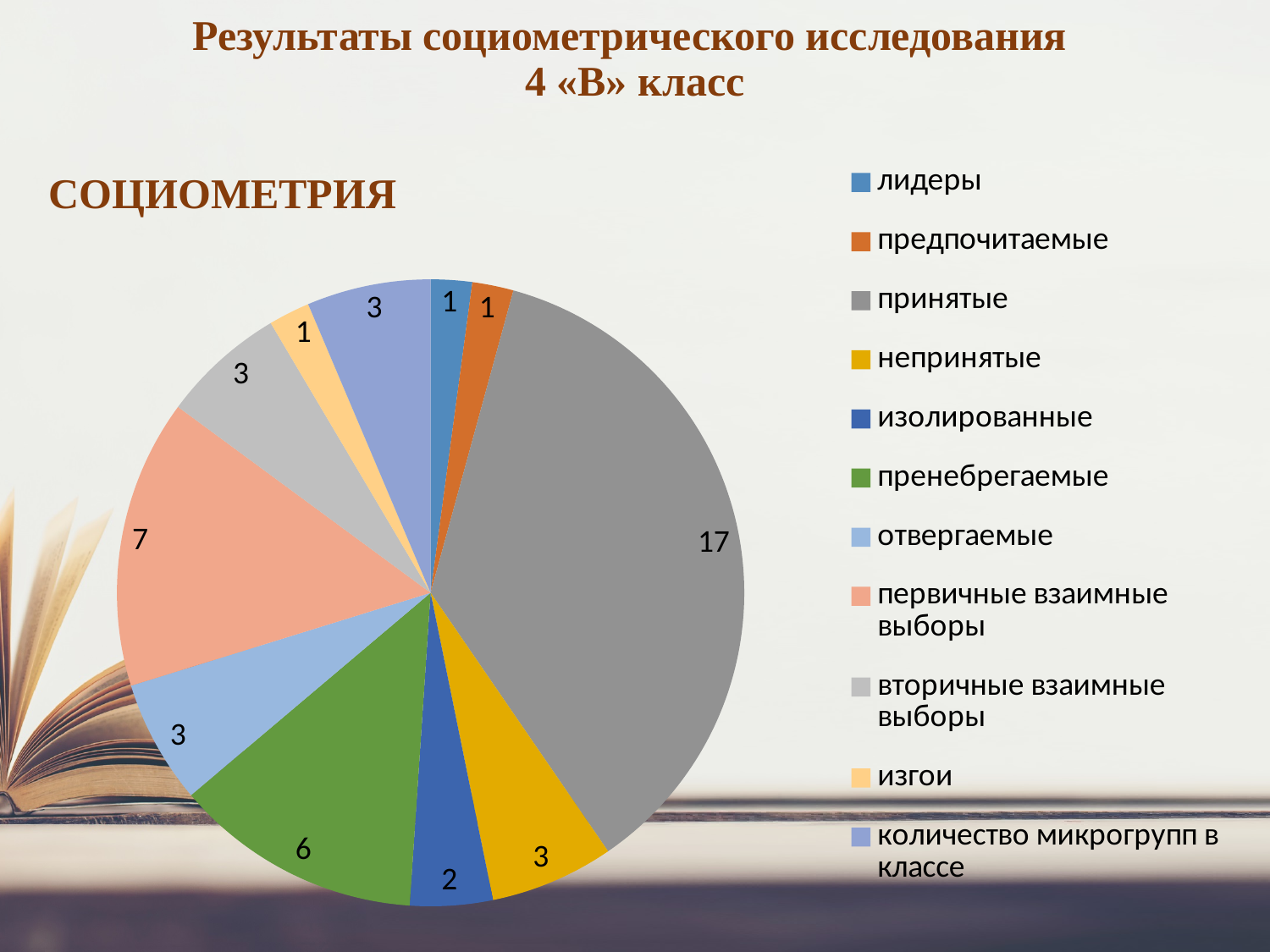
What is the value for изолированные? 2 Which is larger, the value for пренебрегаемые or the value for отвергаемые? пренебрегаемые What is the value for пренебрегаемые? 6 What kind of chart is shown on the slide? pie chart Which category has the largest slice of the pie? принятые What is the title of the pie chart? СОЦИОМЕТРИЯ Which legend entry is shown in green? пренебрегаемые What is the difference between the values for пренебрегаемые and изолированные? 4 What is the difference between the values for принятые and первичные взаимные выборы? 10 What is the value for принятые in the pie chart? 17 What is the value for первичные взаимные выборы? 7 How many categories does the legend list? 11